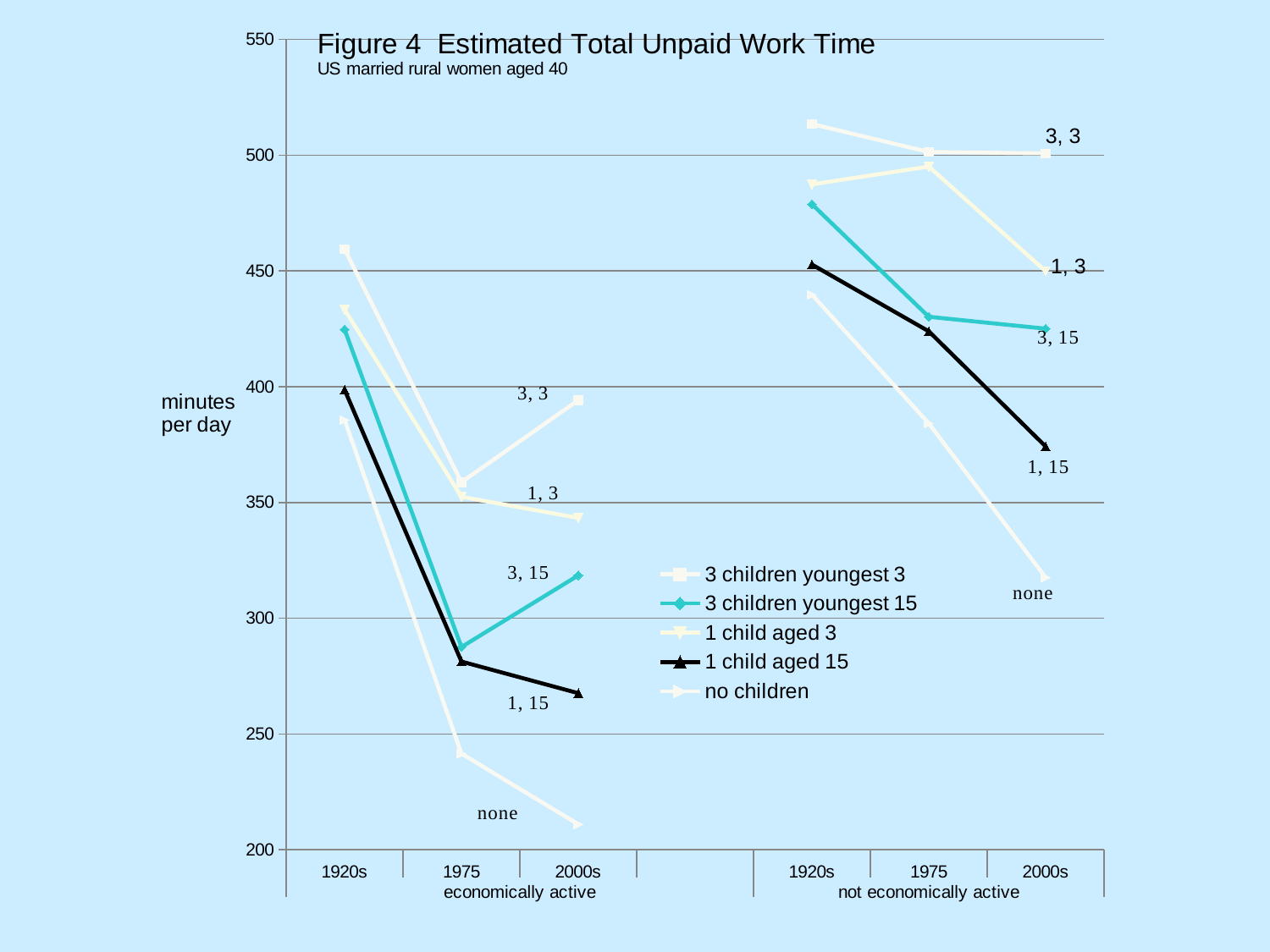
How many time periods are plotted within each group on the x axis? 3 What kind of chart is shown on the slide? line chart Is the value for 'no children' in the 2000s in the economically active group greater or less than 250? less Is the value for '3 children youngest 3' in the 1920s in the not economically active group greater or less than 500? greater Which series has the lowest value in the 2000s in the not economically active group? no children What is the label on the y axis? minutes per day Does the 'no children' series rise or fall from the 1920s to the 2000s in the economically active group? fall Which series has the highest value in the 1920s in the economically active group? 3 children youngest 3 How many series does the legend list? 5 What is the subtitle under the chart title? US married rural women aged 40 Is the value for '3 children youngest 15' in the 2000s in the not economically active group greater or less than 400? greater